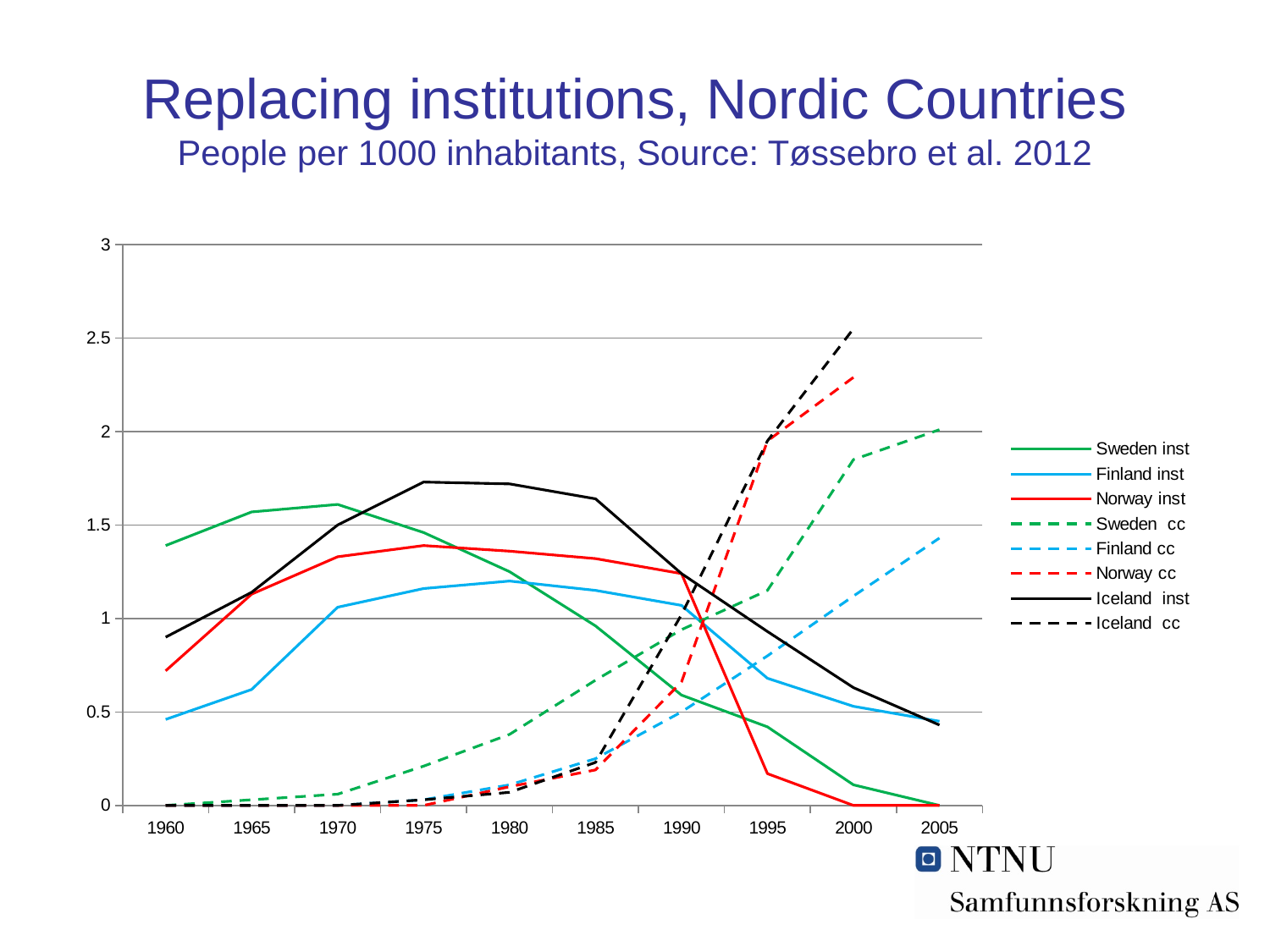
Which series reaches the highest value anywhere on the chart? Iceland cc In 1990, which is larger: Norway inst or Sweden inst? Norway inst Is the value for Iceland cc in 2000 greater or less than 2? greater How many series does the legend list? 8 In 2005, which is larger: Sweden cc or Finland cc? Sweden cc Is the value for Norway inst in 1995 greater or less than 0.5? less What is the title of the chart on the slide? Replacing institutions, Nordic Countries Is the value for Iceland inst in 1975 greater or less than 1.5? greater What kind of chart is shown on the slide? Line chart How many years are labelled along the x axis? 10 Does the Sweden cc series rise or fall from 1960 to 2005? rise